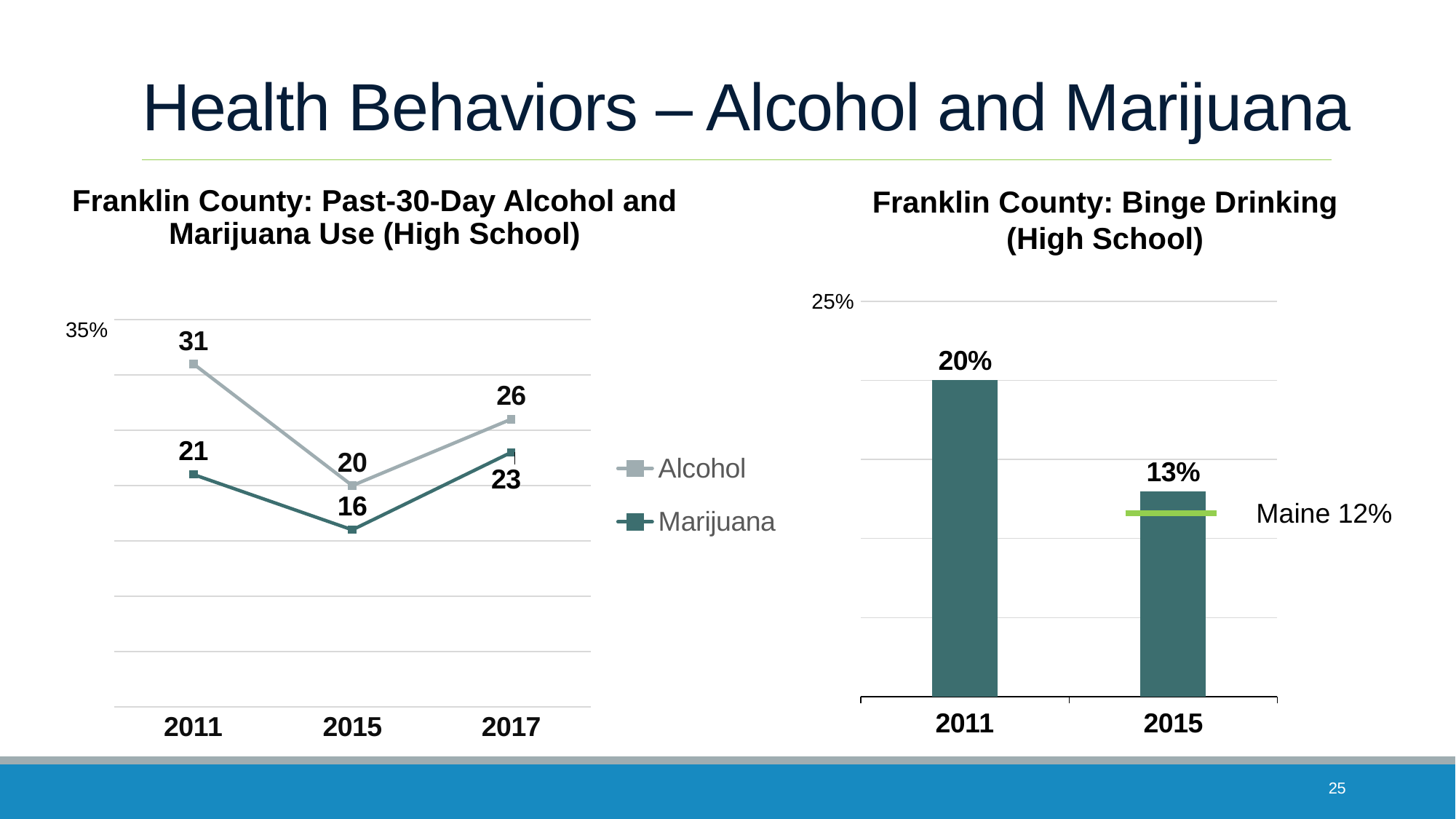
In the 'Franklin County: Past-30-Day Alcohol and Marijuana Use (High School)' chart, what is the Marijuana value for 2015? 16 In the 'Franklin County: Past-30-Day Alcohol and Marijuana Use (High School)' chart, how many series does the legend list? 2 In the 'Franklin County: Past-30-Day Alcohol and Marijuana Use (High School)' chart, does the Marijuana value rise or fall from 2015 to 2017? Rise In the 'Franklin County: Binge Drinking (High School)' chart, what is the difference between the 2011 and 2015 values? 7% In the 'Franklin County: Past-30-Day Alcohol and Marijuana Use (High School)' chart, what is the Alcohol value for 2011? 31 In the 'Franklin County: Binge Drinking (High School)' chart, what Maine value is marked by the green reference line? 12% In the 'Franklin County: Past-30-Day Alcohol and Marijuana Use (High School)' chart, what is the difference between the Alcohol and Marijuana values in 2011? 10 In the 'Franklin County: Binge Drinking (High School)' chart, how many bars are plotted? 2 In the 'Franklin County: Binge Drinking (High School)' chart, what is the value for 2011? 20% In the 'Franklin County: Past-30-Day Alcohol and Marijuana Use (High School)' chart, what kind of chart is it? Line chart In the 'Franklin County: Past-30-Day Alcohol and Marijuana Use (High School)' chart, what is the Marijuana value for 2017? 23 In the 'Franklin County: Past-30-Day Alcohol and Marijuana Use (High School)' chart, which year has the lowest Alcohol value? 2015